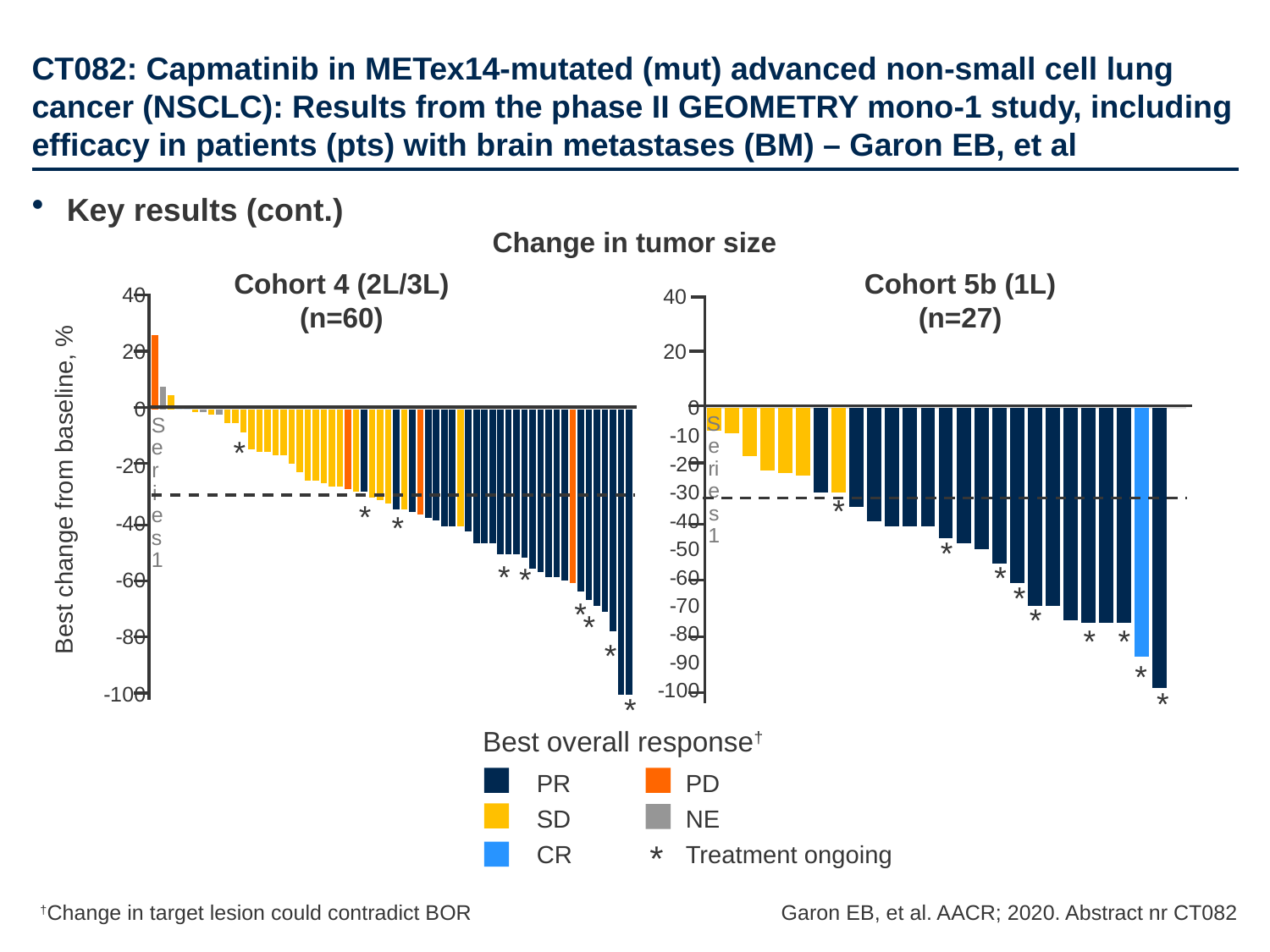
In the Cohort 5b (1L) chart, is the value of the first (leftmost) yellow bar greater or less than -20? greater How many patients are in the Cohort 5b (1L) chart according to its title? 27 In the Cohort 4 (2L/3L) chart, do the bar values rise or fall moving from left to right along the x axis? Fall How many best overall response categories are listed in the colour legend? 5 What is the overall title above the two charts? Change in tumor size How many patients are in the Cohort 4 (2L/3L) chart according to its title? 60 In the Cohort 4 (2L/3L) chart, is the value of the lowest bar greater or less than -80? less In the Cohort 5b (1L) chart, is the value of the light blue CR bar greater or less than -80? less In the legend, which best overall response category is shown in light blue? CR What kind of chart is used for Cohort 4 (2L/3L) on the slide? Bar chart Which chart has more bars, Cohort 4 (2L/3L) or Cohort 5b (1L)? Cohort 4 (2L/3L)